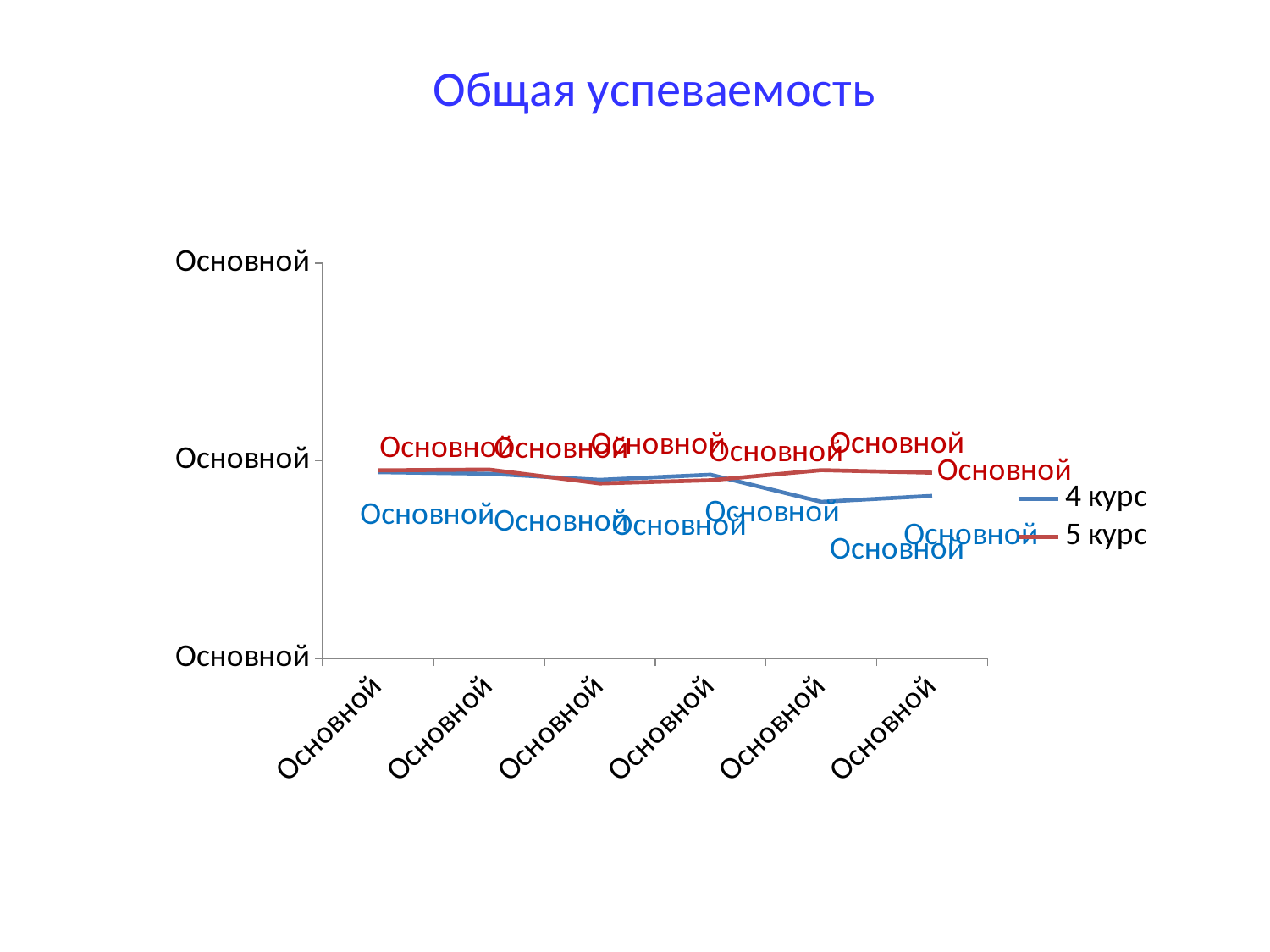
What kind of chart is shown on the slide? line chart At the last (sixth) point on the x axis, which series is higher, 4 курс or 5 курс? 5 курс Which series is drawn in red? 5 курс At the fifth point from the left, which series has the higher value, 4 курс or 5 курс? 5 курс What are the series names listed in the legend? 4 курс, 5 курс How many points are plotted along the x axis for each series? 6 How many series does the legend list? 2 What is the title of the chart? Общая успеваемость